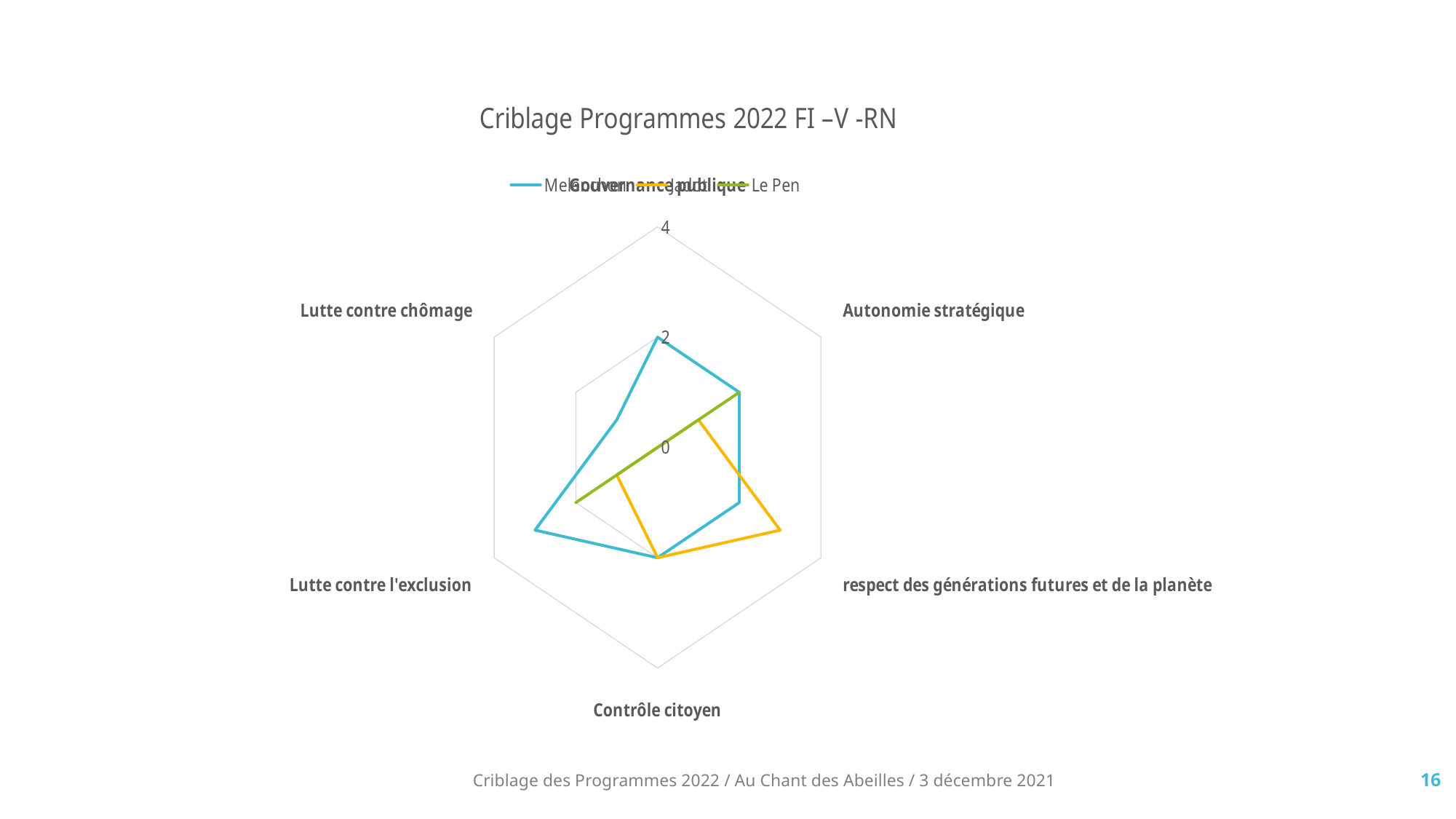
What is the value of the blue series for Gouvernance publique? 2 For Lutte contre l'exclusion, which series has the larger value, the blue series or the yellow series? Blue series What is the title of the chart? Criblage Programmes 2022 FI –V -RN What is the value of the yellow series for Gouvernance publique? 0 Is the value of the blue series for Lutte contre chômage greater or less than 2? less What is the highest value shown on the radar chart's axis scale? 4 For respect des générations futures et de la planète, which series has the larger value, the yellow series or the green series? Yellow series Is the value of the yellow series for respect des générations futures et de la planète greater or less than 2? greater How many series does the legend list? 3 How many categories (axes) does the radar chart have? 6 Is the value of the blue series for Lutte contre l'exclusion greater or less than 2? greater What kind of chart is shown on the slide? Radar chart